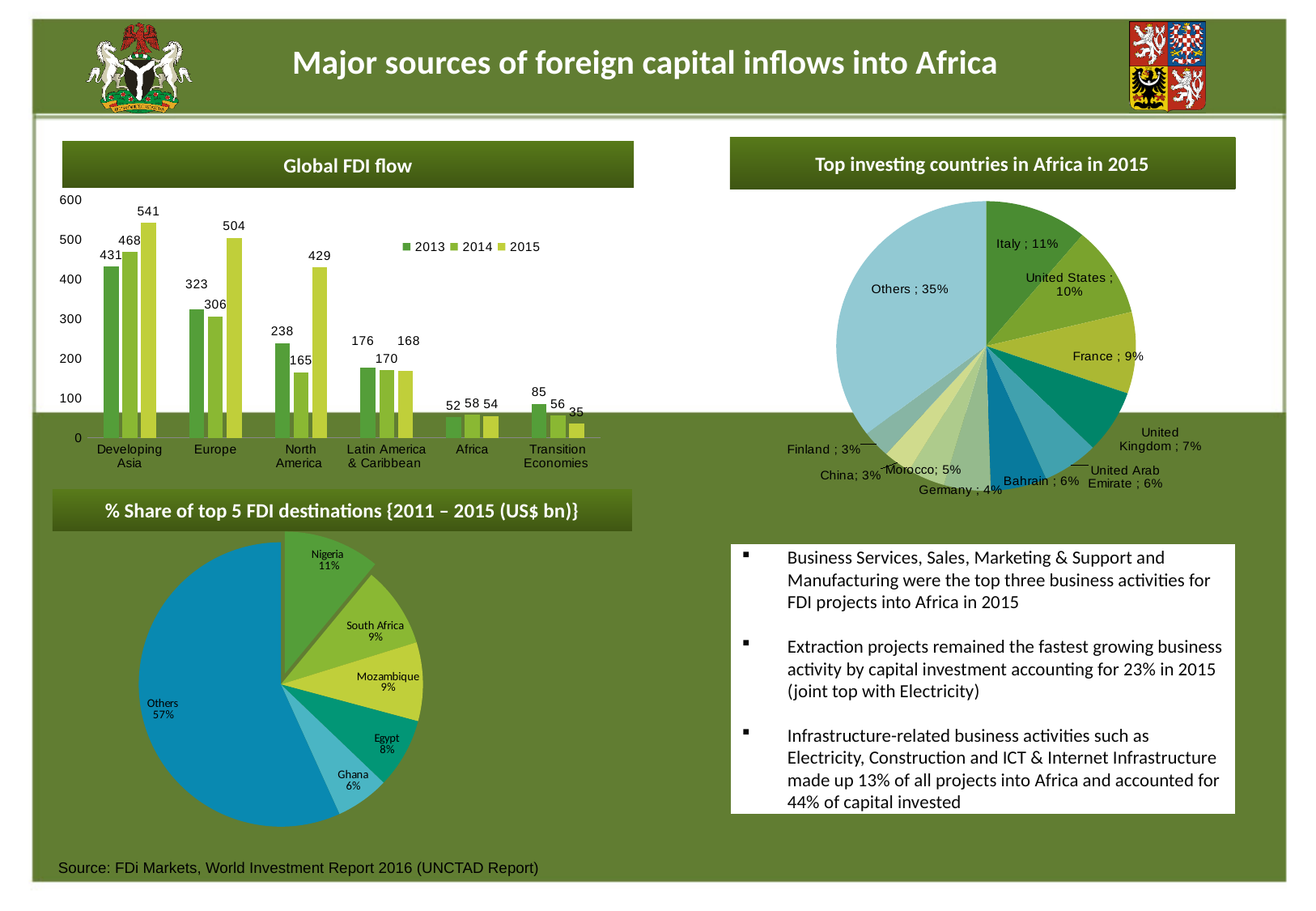
In the Global FDI flow chart, how many regions are shown on the x axis? 6 In the Global FDI flow chart, what is the value for North America in 2014? 165 In the Global FDI flow chart, what is the difference between Europe's 2015 and 2014 values? 198 In the Top investing countries in Africa in 2015 chart, what share does Italy have? 11% What kind of chart is the Global FDI flow chart? bar chart In the % Share of top 5 FDI destinations chart, what share does Ghana have? 6% In the Global FDI flow chart, do the values for Transition Economies rise or fall from 2013 to 2015? fall In the Top investing countries in Africa in 2015 chart, which named country (excluding Others) has the largest share? Italy In the Global FDI flow chart, which region has the lowest value in 2015? Transition Economies In the Global FDI flow chart, which is larger: Africa in 2014 or Transition Economies in 2014? Africa in 2014 In the Global FDI flow chart, how many series does the legend list? 3 In the Global FDI flow chart, what is the value for Developing Asia in 2015? 541